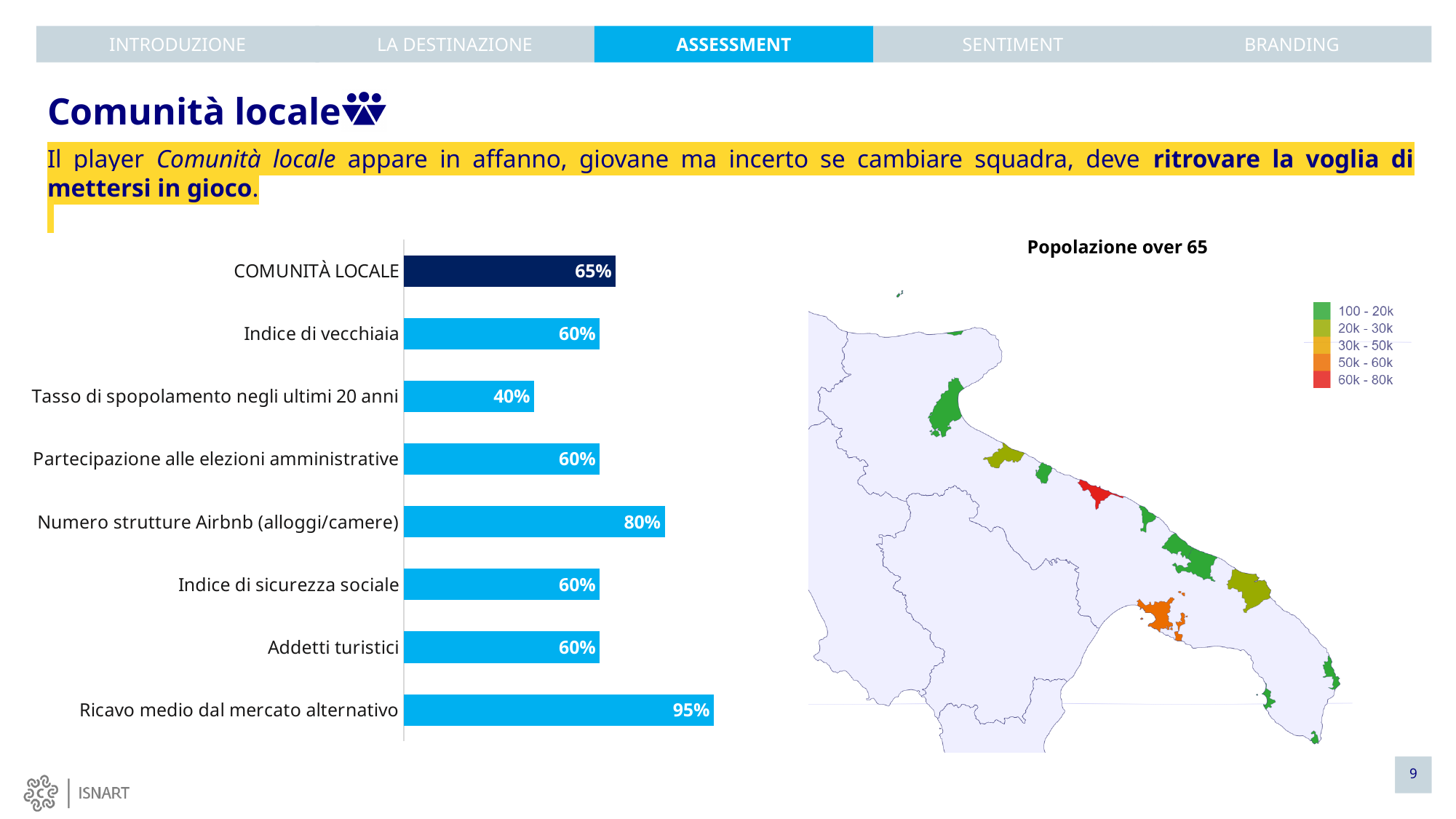
In the bar chart on the left, what is the difference between COMUNITÀ LOCALE and Indice di vecchiaia? 5% In the bar chart on the left, which category has the lowest value? Tasso di spopolamento negli ultimi 20 anni In the bar chart on the left, what is the value for Numero strutture Airbnb (alloggi/camere)? 80% What is the title of the map on the right of the slide? Popolazione over 65 In the bar chart on the left, what is the value for COMUNITÀ LOCALE? 65% In the bar chart on the left, which is larger: Numero strutture Airbnb (alloggi/camere) or Addetti turistici? Numero strutture Airbnb (alloggi/camere) In the bar chart on the left, what is the value for Ricavo medio dal mercato alternativo? 95% What kind of chart is shown on the left of the slide? Bar chart How many categories are shown in the bar chart on the left? 8 In the bar chart on the left, what is the value for Tasso di spopolamento negli ultimi 20 anni? 40% In the bar chart on the left, which category has the highest value? Ricavo medio dal mercato alternativo In the bar chart on the left, what is the difference between Ricavo medio dal mercato alternativo and Numero strutture Airbnb (alloggi/camere)? 15%